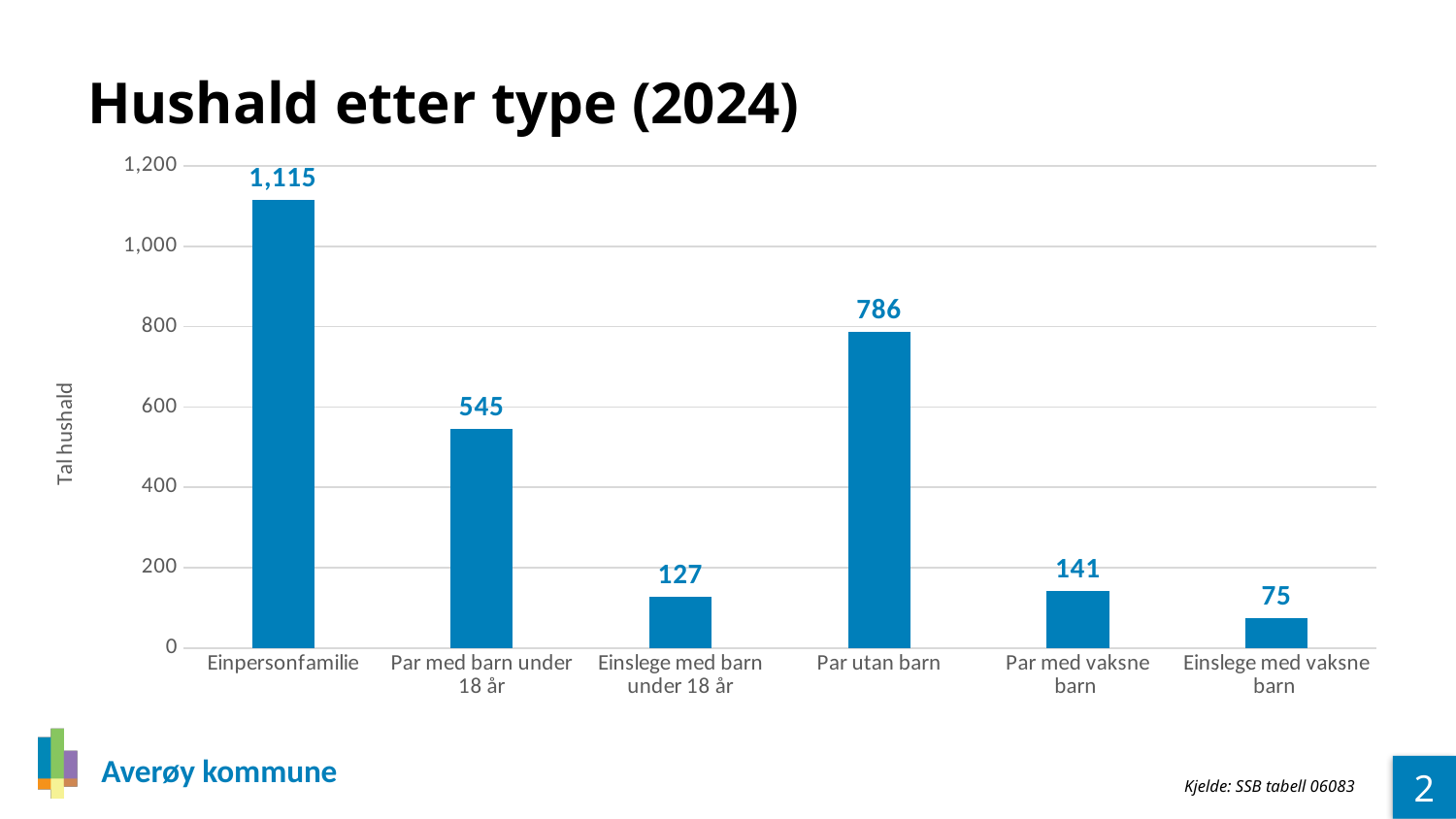
Which category has the lowest value? Einslege med vaksne barn Which category has the highest value? Einpersonfamilie Which is larger, the value for Par med barn under 18 år or the value for Par utan barn? Par utan barn What is the title of the chart? Hushald etter type (2024) What is the difference between the values for Einpersonfamilie and Par utan barn? 329 Is the value for Par med barn under 18 år greater or less than 600? less What is the value for Einslege med vaksne barn? 75 What is the value for Par utan barn? 786 What is the difference between the values for Par med vaksne barn and Einslege med barn under 18 år? 14 How many categories are shown on the x axis? 6 What kind of chart is shown on the slide? bar chart What is the value for Einpersonfamilie? 1,115